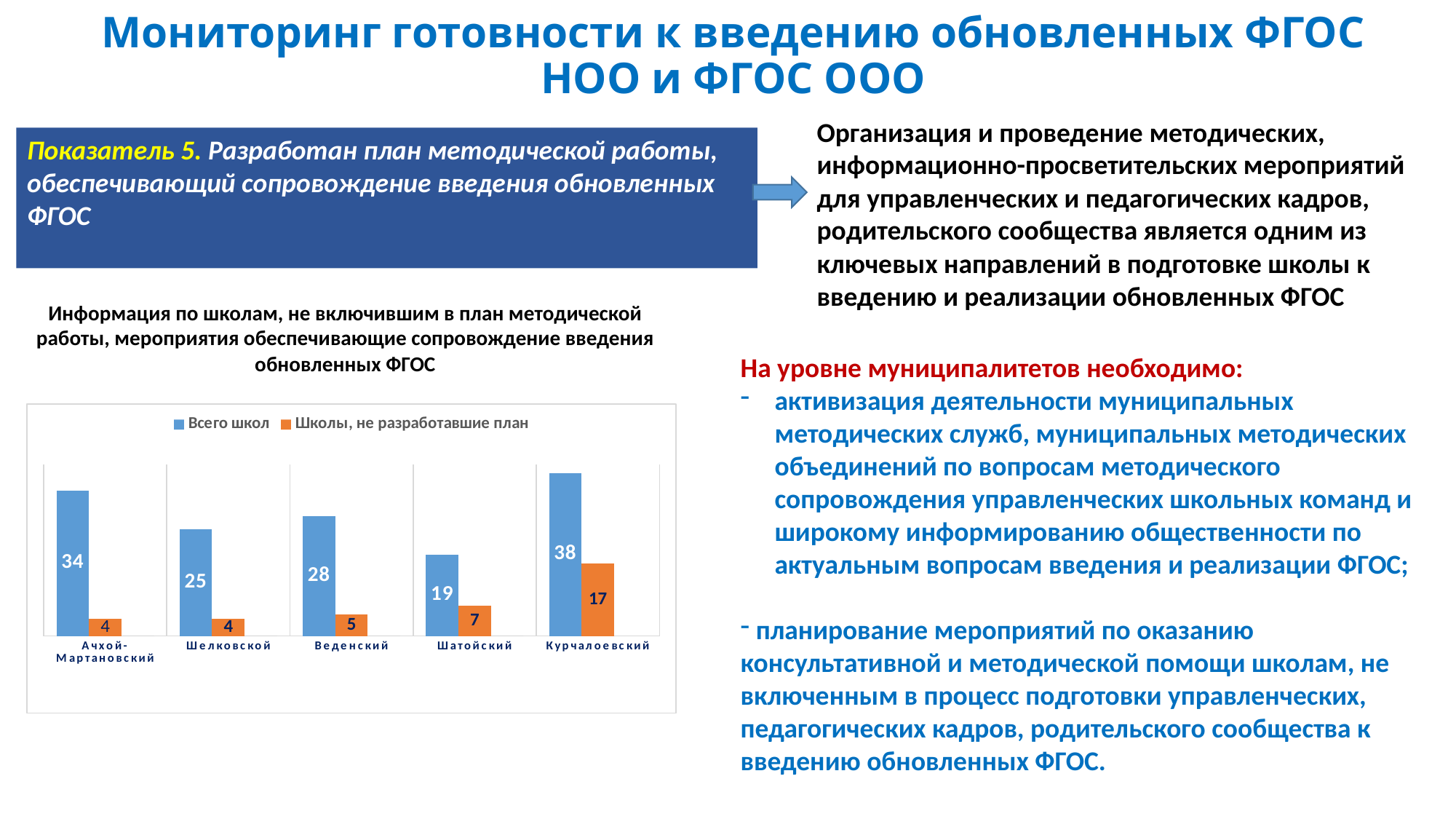
What is the difference between "Всего школ" and "Школы, не разработавшие план" for Веденский? 23 How many categories are shown on the x axis of the chart? 5 What is the value of "Всего школ" for Ачхой-Мартановский? 34 What kind of chart is shown on the slide? Bar chart Which category has the highest value for "Школы, не разработавшие план"? Курчалоевский Which colour represents the series "Школы, не разработавшие план" in the chart? Orange How many series does the chart legend list? 2 What is the difference in "Всего школ" between Курчалоевский and Шелковской? 13 Which category has the lowest value for "Всего школ"? Шатойский Which is larger: "Всего школ" for Шелковской or for Веденский? Веденский What is the value of "Школы, не разработавшие план" for Шатойский? 7 What is the value of "Всего школ" for Курчалоевский? 38